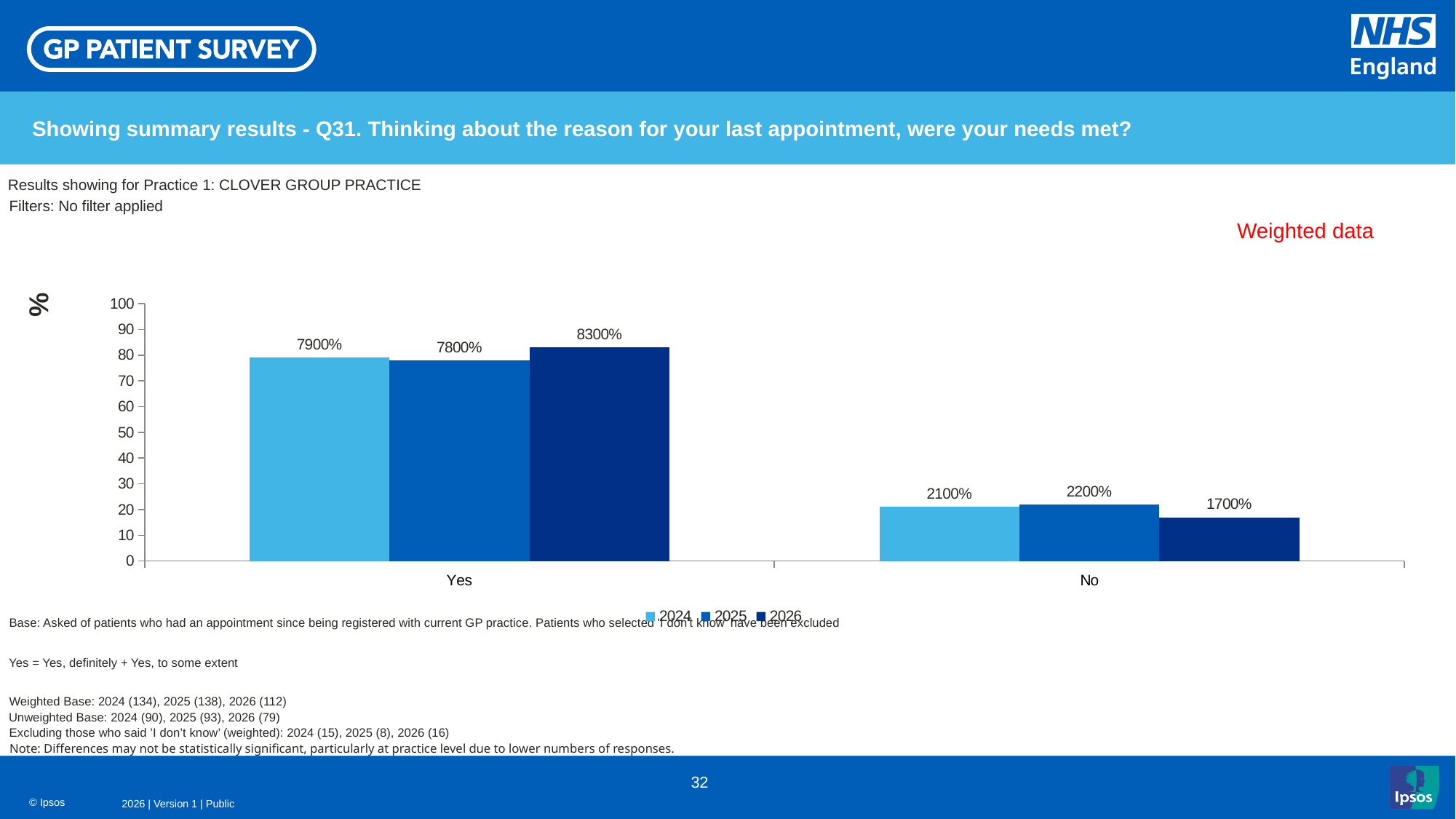
Which year has the highest value in the Yes category? 2026 What is the value for 2026 in the Yes category? 8300% How many series does the legend list? 3 How many categories are shown on the x axis? 2 Which year has the lowest value in the No category? 2026 What is the value for 2026 in the No category? 1700% What is the value for 2024 in the Yes category? 7900% Is the 2025 value for Yes greater or less than 70 on the axis? greater What is the value for 2025 in the No category? 2200% Which practice are the results shown for? Practice 1: CLOVER GROUP PRACTICE Which is larger in the No category, the 2024 value or the 2025 value? 2025 What kind of chart is shown on the slide? bar chart